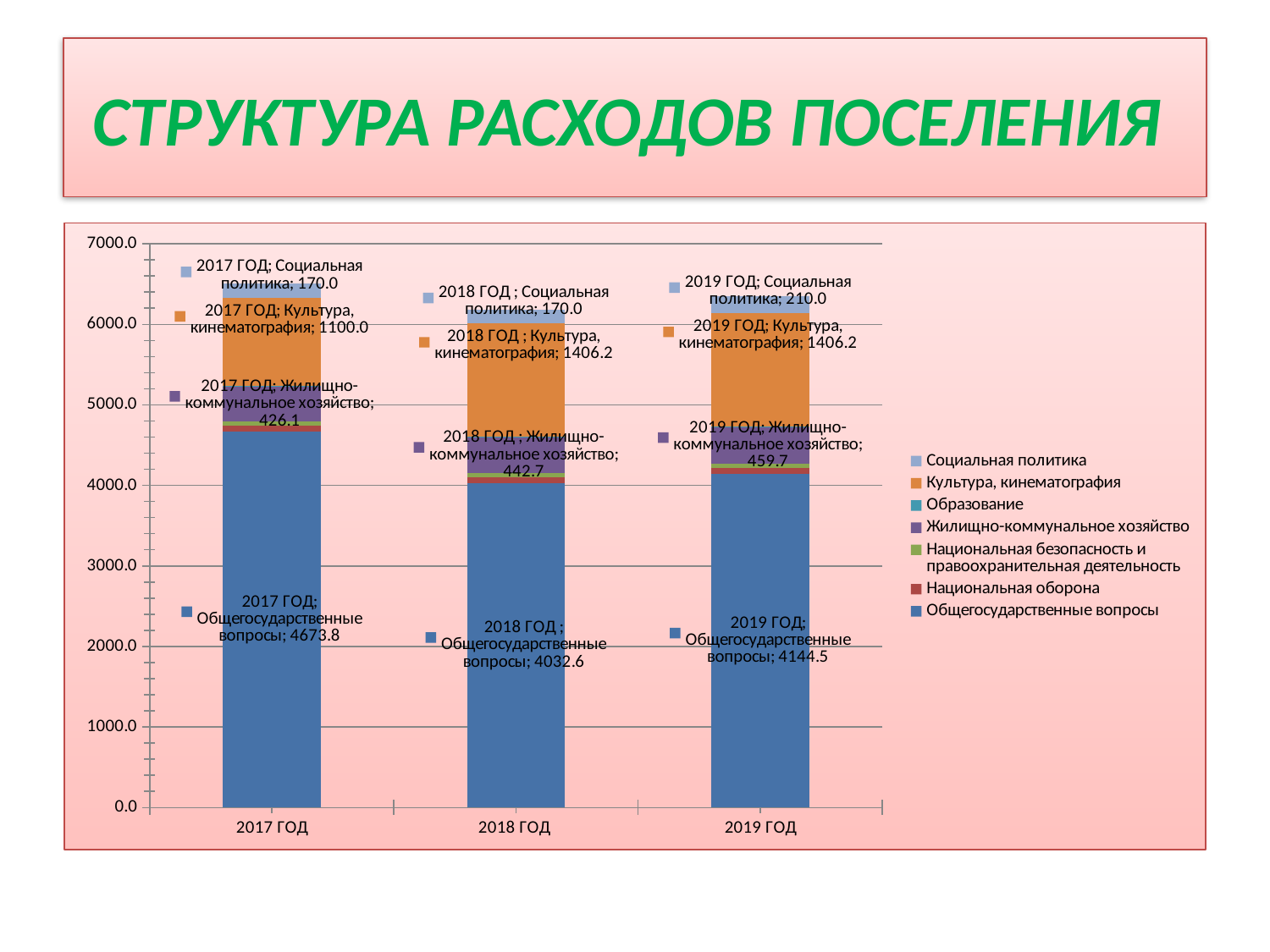
What is the value of Социальная политика for 2019 ГОД? 210.0 What is the value of Общегосударственные вопросы for 2018 ГОД? 4032.6 Which is larger: Жилищно-коммунальное хозяйство in 2019 ГОД or in 2017 ГОД? 2019 ГОД What kind of chart is shown on the slide? stacked bar chart How many years (categories) are shown on the x axis? 3 What is the value of Жилищно-коммунальное хозяйство for 2018 ГОД? 442.7 How many series does the legend list? 7 Is the total height of the 2018 ГОД bar greater or less than 5000.0? greater What is the value of Культура, кинематография for 2019 ГОД? 1406.2 What is the difference between Культура, кинематография in 2018 ГОД and in 2017 ГОД? 306.2 What is the value of Общегосударственные вопросы for 2017 ГОД? 4673.8 Which year has the highest value for Общегосударственные вопросы? 2017 ГОД